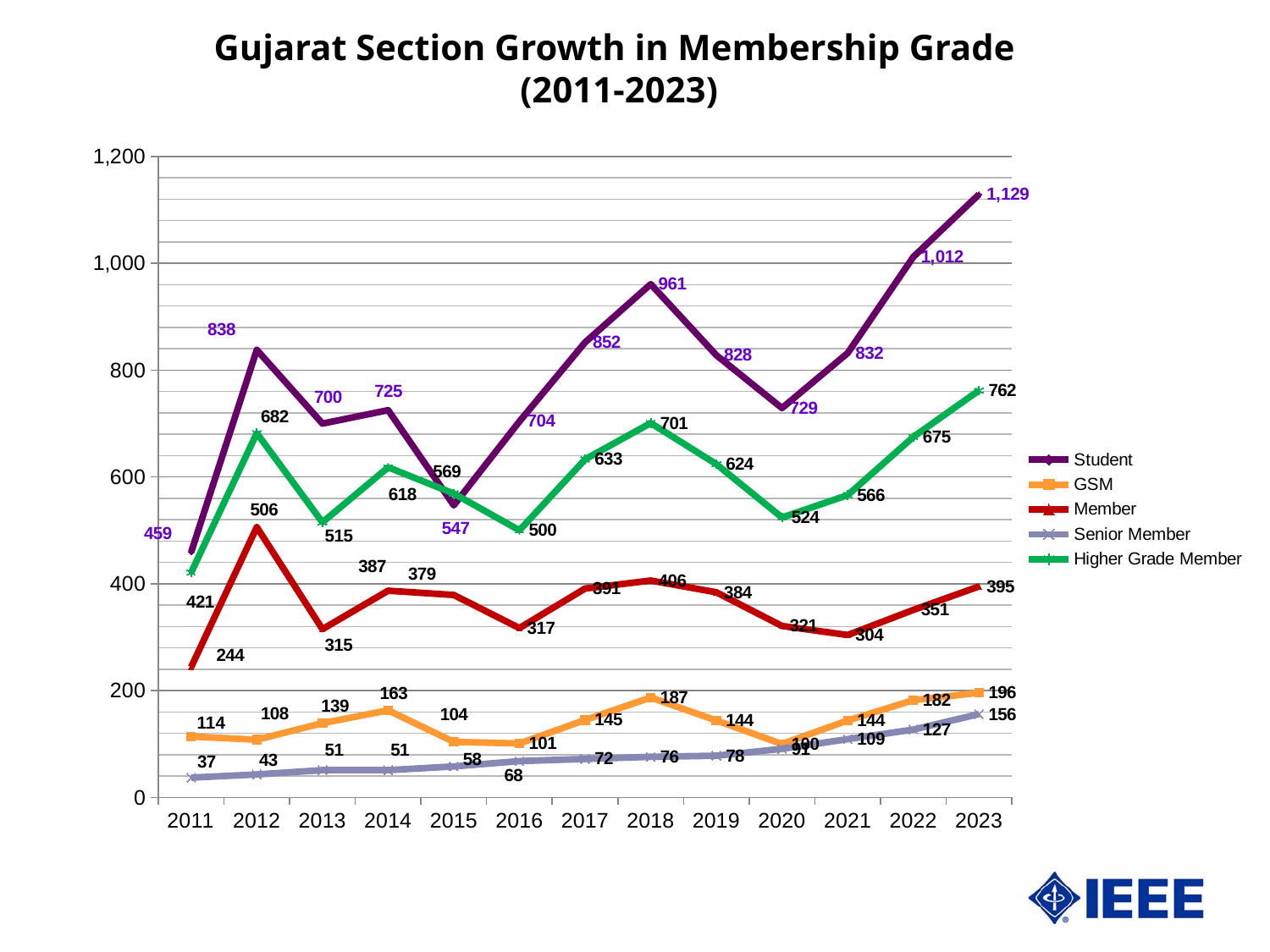
Does the Senior Member series generally rise or fall from 2011 to 2023? rise What kind of chart is shown on the slide? line chart What is the value for Student in 2023? 1,129 What is the value for Senior Member in 2016? 68 What is the title of the chart? Gujarat Section Growth in Membership Grade (2011-2023) Which is larger: GSM in 2018 or Senior Member in 2023? GSM in 2018 How many years are plotted along the x axis? 13 In which year is the Member series lowest? 2011 In which year is the Student series highest? 2023 How many series does the legend list? 5 What is the difference between the Student values for 2023 and 2022? 117 What is the value for Higher Grade Member in 2018? 701